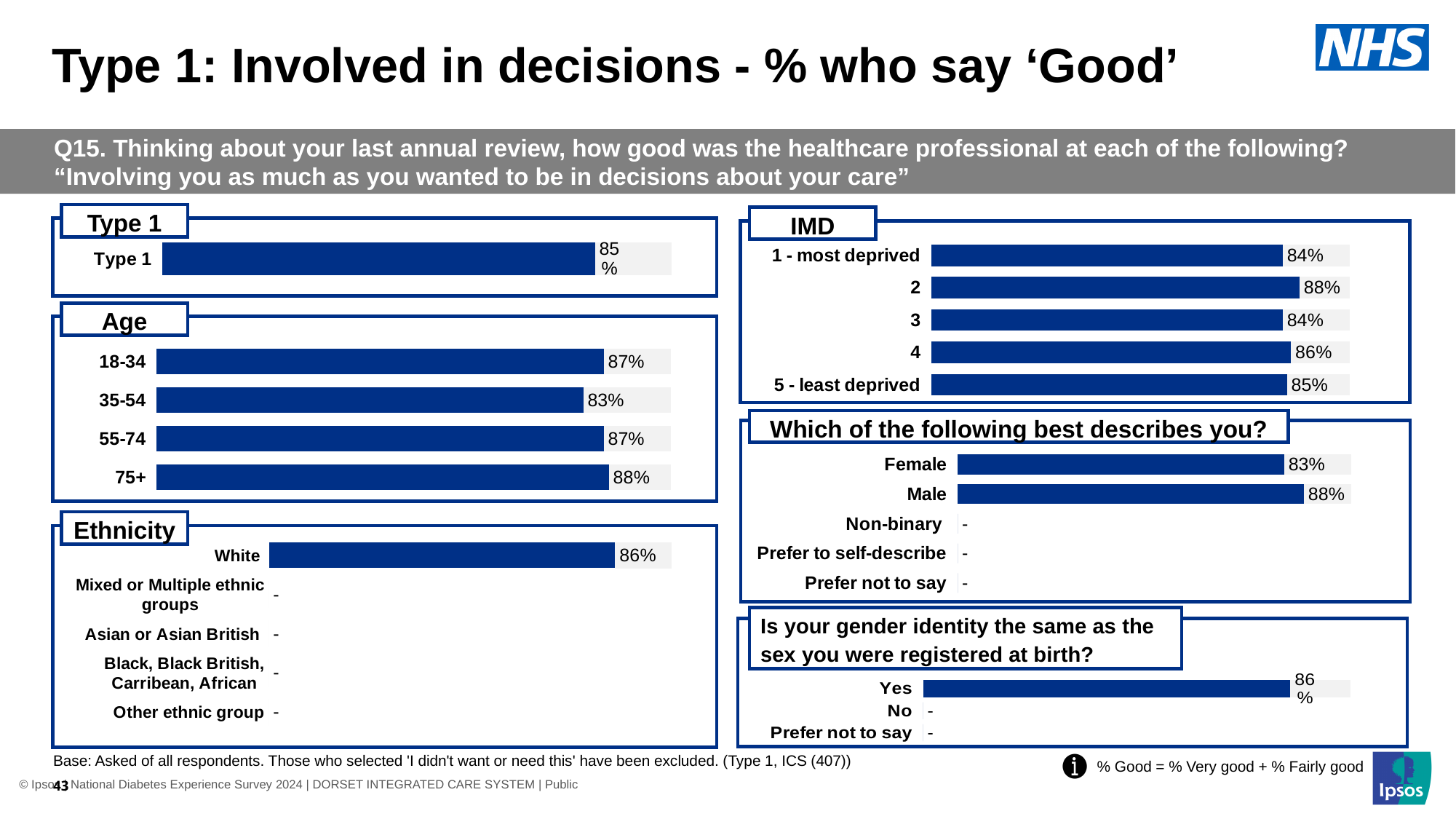
In the Age chart, which age group has the lowest value? 35-54 In the Type 1 chart, what percentage of Type 1 respondents say 'Good'? 85% In the IMD chart, which IMD group has the highest value? 2 In the 'Is your gender identity the same as the sex you were registered at birth?' chart, what is the value for Yes? 86% In the IMD chart, how many IMD categories are shown? 5 In the Age chart, which age group has the highest value? 75+ In the IMD chart, what is the value for IMD group 2? 88% In the Age chart, what is the value for the 35-54 age group? 83% In the 'Which of the following best describes you?' chart, what is the difference between the Male and Female values? 5 percentage points In the Ethnicity chart, what is the value for White respondents? 86% In the 'Which of the following best describes you?' chart, which is larger, Female or Male? Male In the Age chart, what is the difference between the 75+ and 35-54 values? 5 percentage points